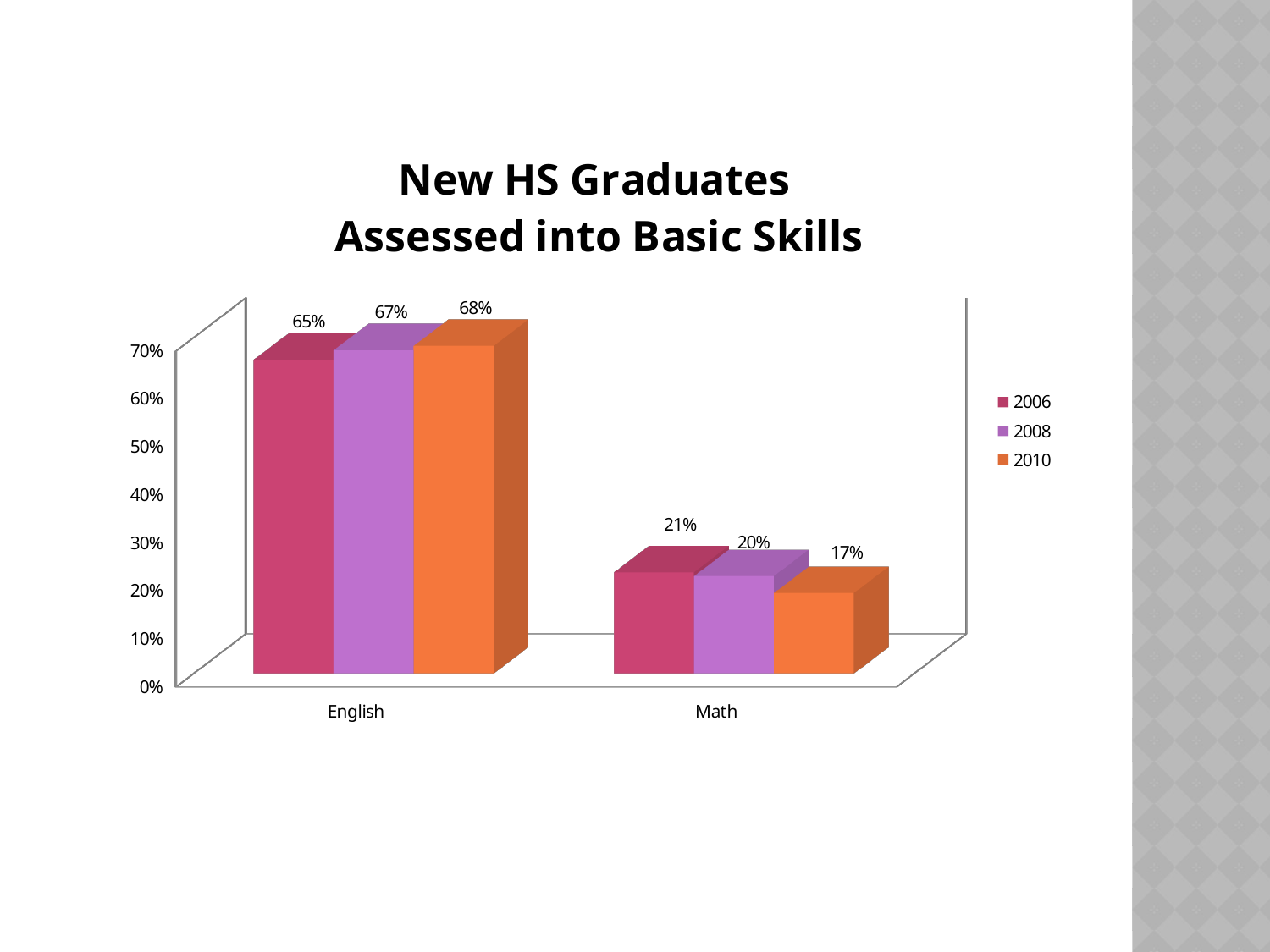
What is the difference between the Math value in 2006 and the Math value in 2010? 4% Which year has the lowest value for Math? 2010 Which is larger, the Math value in 2008 or the Math value in 2010? 2008 What is the value for Math in 2010? 17% Which year has the highest value for English? 2010 What is the value for English in 2008? 67% What is the title of the chart? New HS Graduates Assessed into Basic Skills What is the value for English in 2006? 65% What is the difference between the English value in 2010 and the English value in 2006? 3% How many series does the legend list? 3 What kind of chart is shown on the slide? Bar chart What is the value for Math in 2006? 21%